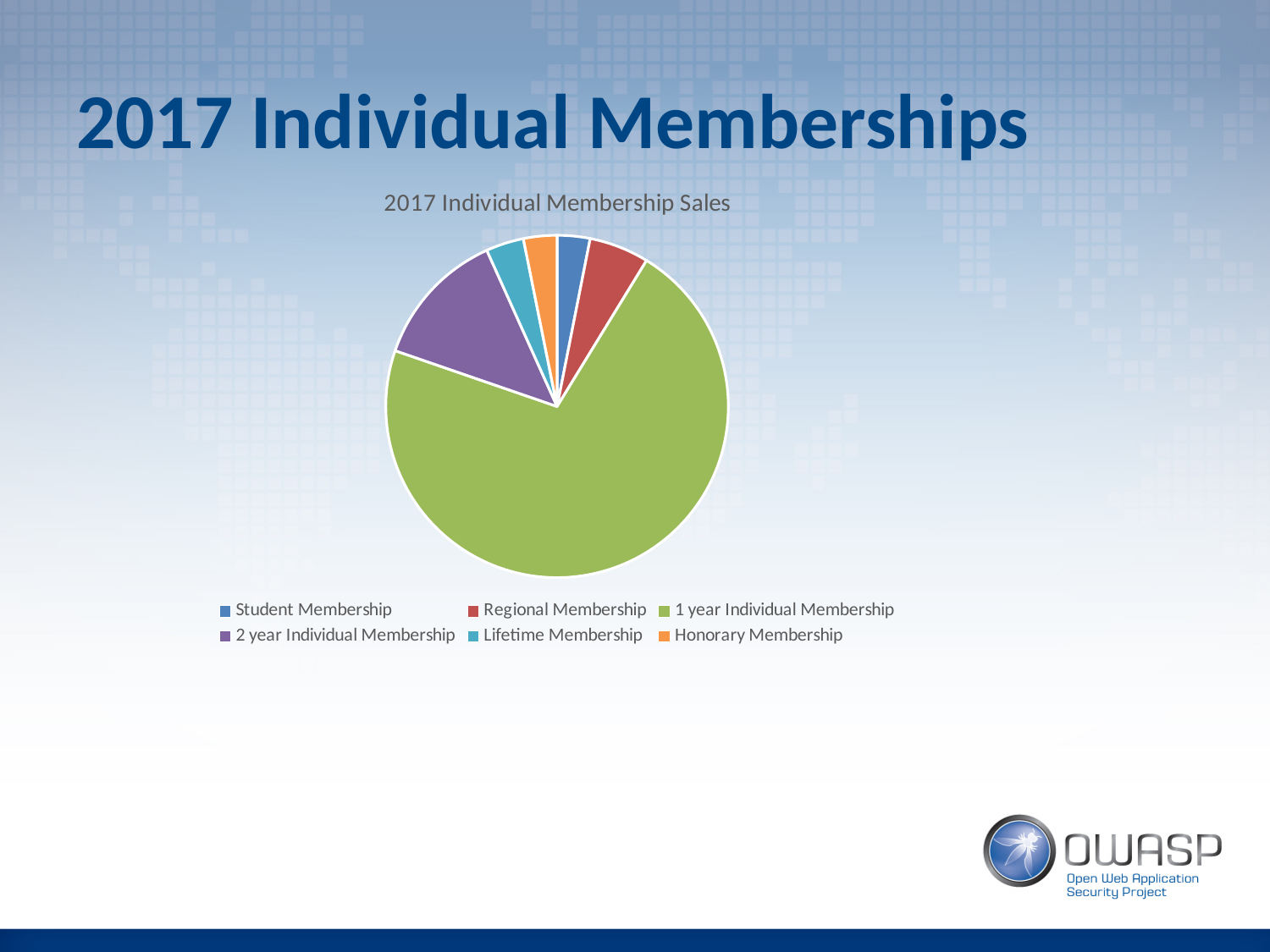
How many membership categories does the pie chart show? 6 Which category has the second-largest slice of the pie? 2 year Individual Membership Which is larger, the slice for Regional Membership or the slice for Student Membership? Regional Membership What kind of chart is shown on the slide? pie chart Is the share of the pie for 1 year Individual Membership greater or less than 50%? greater Which is larger, the slice for 2 year Individual Membership or the slice for Regional Membership? 2 year Individual Membership Which is larger, the slice for 1 year Individual Membership or the slice for 2 year Individual Membership? 1 year Individual Membership How many entries does the legend list? 6 What is the title of the chart? 2017 Individual Membership Sales What colour is the slice for 1 year Individual Membership? green Which membership category has the largest slice of the pie? 1 year Individual Membership